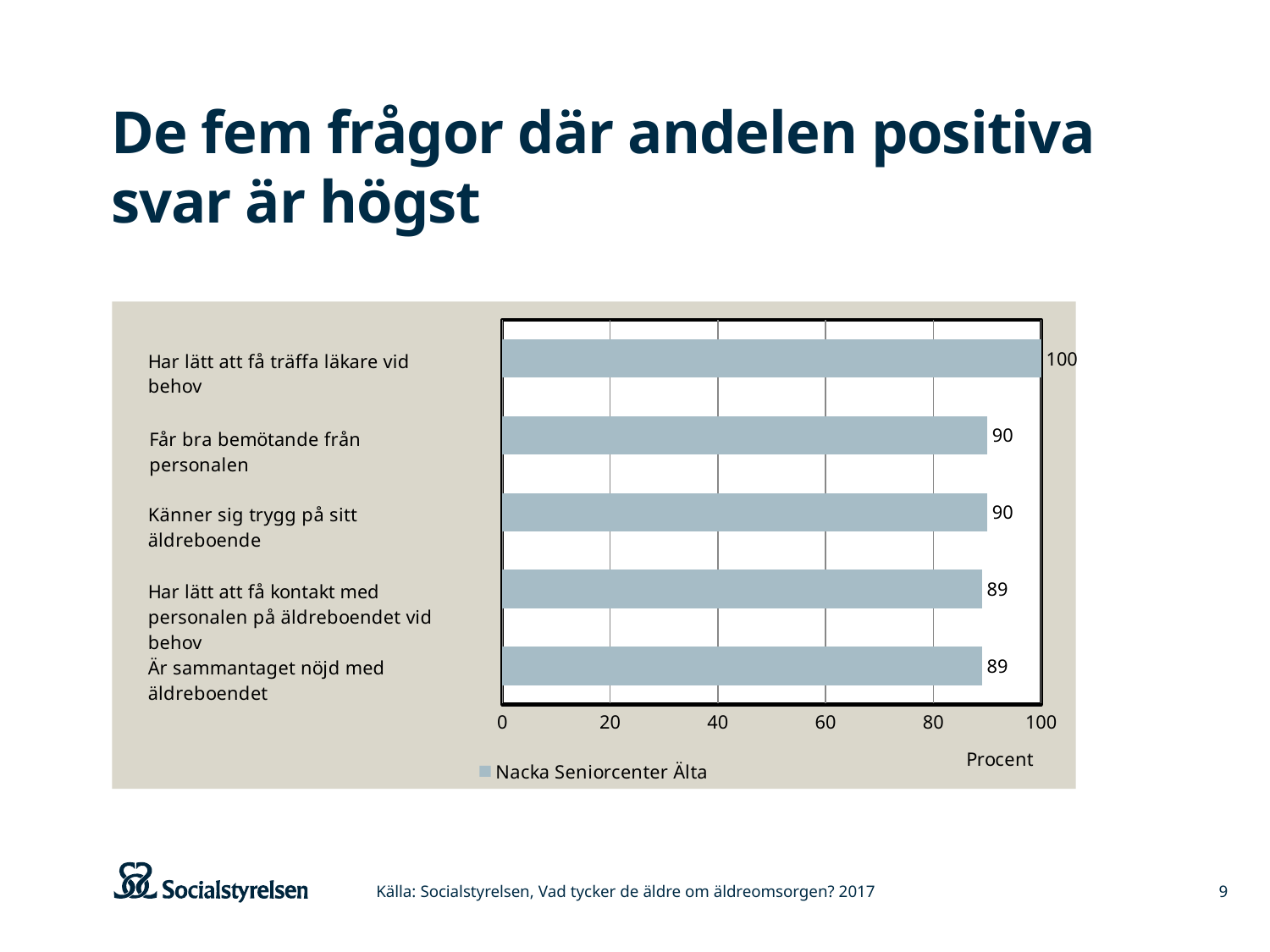
What is the value for "Har lätt att få träffa läkare vid behov"? 100 What kind of chart is shown on the slide? Bar chart What is the value for "Är sammantaget nöjd med äldreboendet"? 89 What is the series name shown in the legend? Nacka Seniorcenter Älta How many categories are shown in the chart? 5 How many series does the legend list? 1 What is the value for "Får bra bemötande från personalen"? 90 What is the difference between the values for "Har lätt att få träffa läkare vid behov" and "Känner sig trygg på sitt äldreboende"? 10 Which category has the highest value? Har lätt att få träffa läkare vid behov What is the difference between the values for "Får bra bemötande från personalen" and "Är sammantaget nöjd med äldreboendet"? 1 Which is larger: the value for "Har lätt att få träffa läkare vid behov" or the value for "Får bra bemötande från personalen"? Har lätt att få träffa läkare vid behov What is the value for "Har lätt att få kontakt med personalen på äldreboendet vid behov"? 89